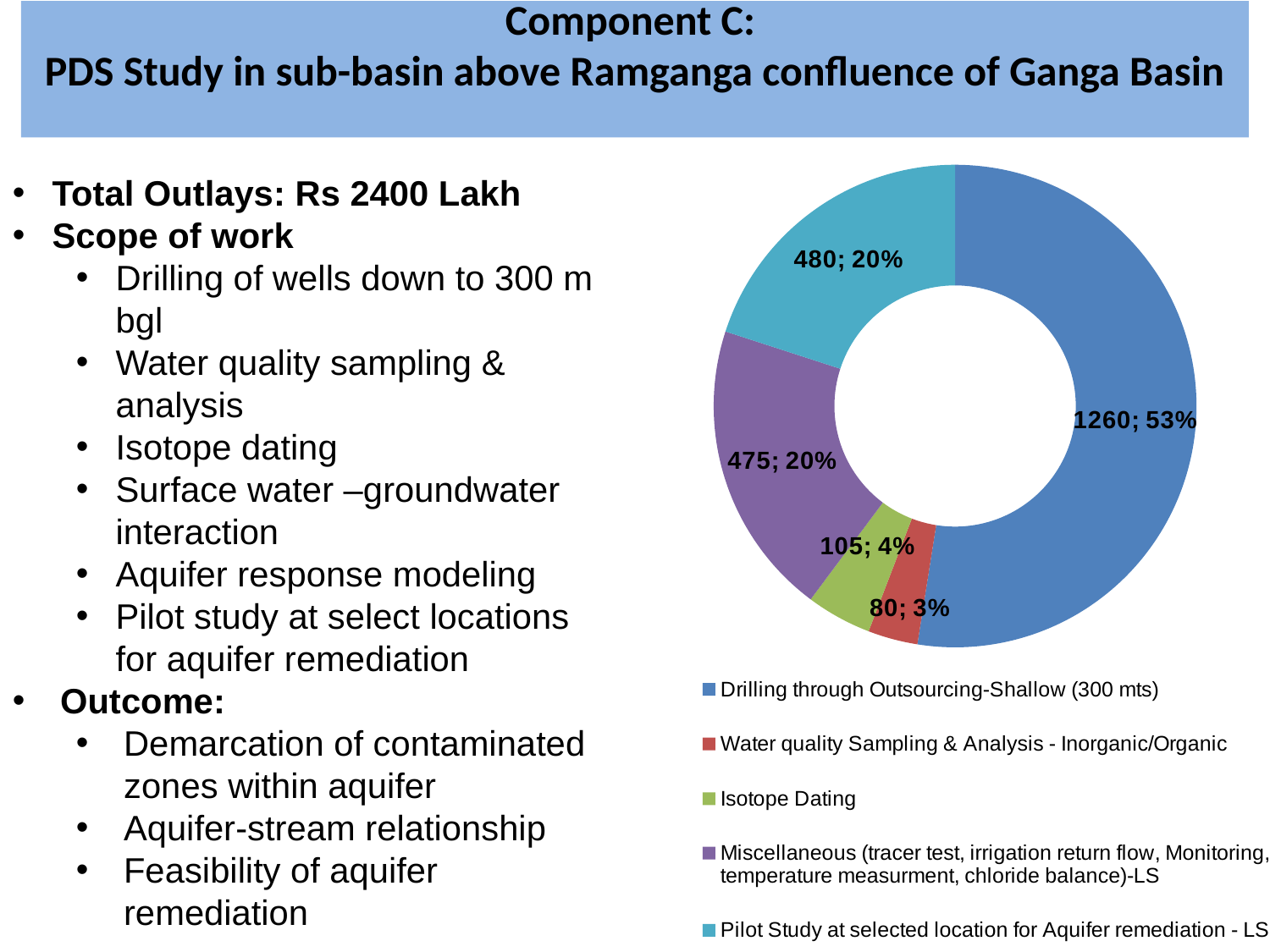
Which category has the smallest slice? Water quality Sampling & Analysis - Inorganic/Organic What is the value for Drilling through Outsourcing-Shallow (300 mts)? 1260 What is the total of all the values shown in the chart? 2400 What is the value for Isotope Dating? 105 What share of the chart does Drilling through Outsourcing-Shallow (300 mts) represent? 53% What share of the chart does Isotope Dating represent? 4% What kind of chart is shown on the slide? Doughnut (pie) chart What is the value for Water quality Sampling & Analysis - Inorganic/Organic? 80 Which category has the largest slice? Drilling through Outsourcing-Shallow (300 mts) What is the difference between the values for Pilot Study at selected location for Aquifer remediation - LS and Miscellaneous (tracer test, irrigation return flow, Monitoring, temperature measurment, chloride balance)-LS? 5 What is the value for Pilot Study at selected location for Aquifer remediation - LS? 480 How many categories does the chart show? 5